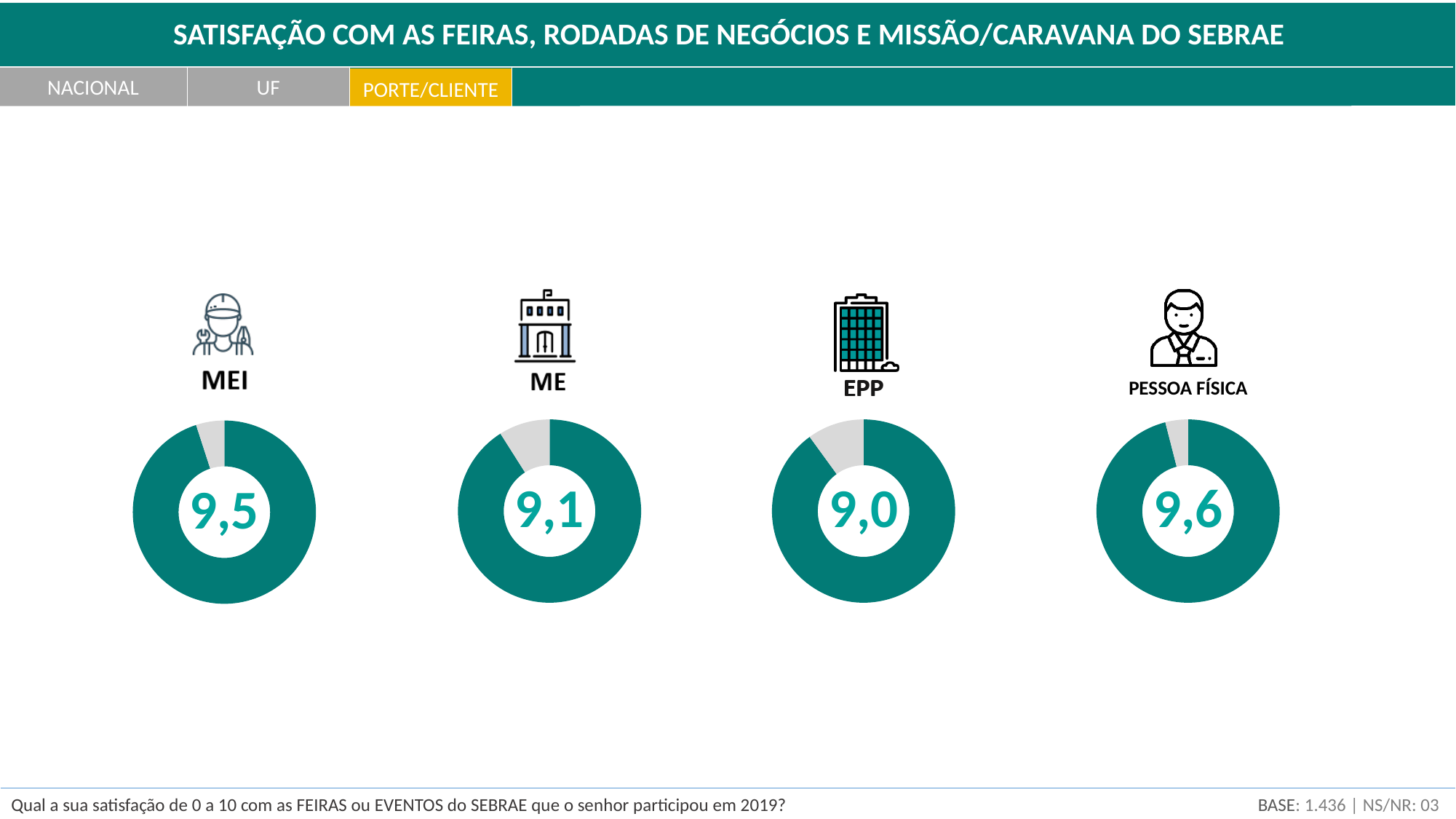
Which tab is highlighted in yellow at the top of the slide? PORTE/CLIENTE What satisfaction score is shown in the donut chart for PESSOA FÍSICA? 9,6 What satisfaction score is shown in the donut chart for ME? 9,1 Which has a higher satisfaction score, MEI or ME? MEI What satisfaction score is shown in the donut chart for EPP? 9,0 What kind of chart is used to display each group's satisfaction score? Donut chart What is the difference between the satisfaction scores of MEI and ME? 0,4 How many groups (donut charts) are shown on the slide? 4 Which group has the lowest satisfaction score among the four donut charts? EPP What satisfaction score is shown in the donut chart for MEI? 9,5 Which group has the highest satisfaction score among the four donut charts? PESSOA FÍSICA What is the difference between the satisfaction scores of PESSOA FÍSICA and EPP? 0,6